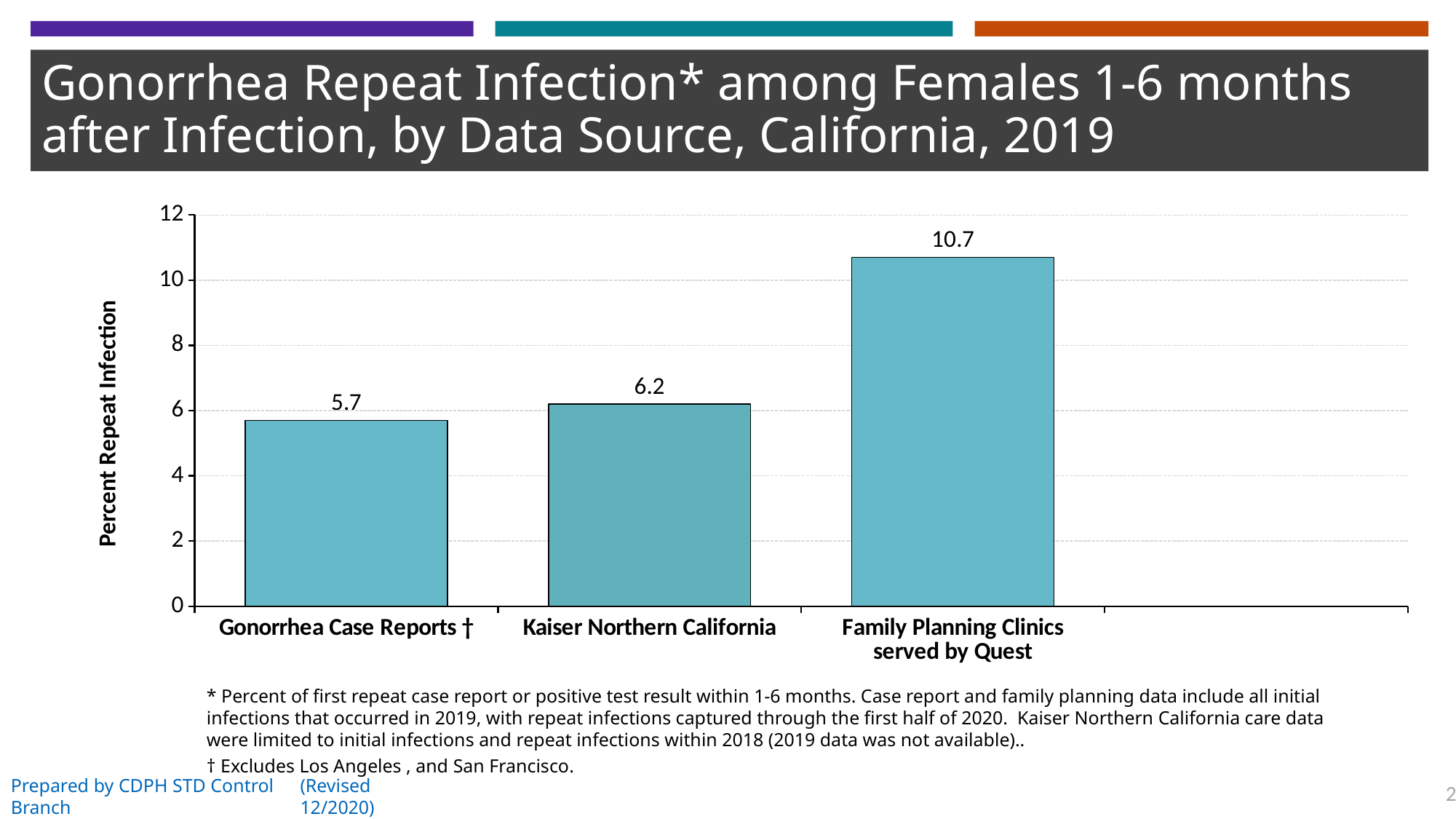
What is the percent repeat infection for Gonorrhea Case Reports? 5.7 What is the percent repeat infection for Family Planning Clinics served by Quest? 10.7 What is the difference in percent repeat infection between Kaiser Northern California and Gonorrhea Case Reports? 0.5 Is the value for Family Planning Clinics served by Quest greater or less than 10? greater Which has a higher percent repeat infection, Kaiser Northern California or Family Planning Clinics served by Quest? Family Planning Clinics served by Quest What is the percent repeat infection for Kaiser Northern California? 6.2 What kind of chart is shown on the slide? Bar chart How many data sources are shown in the chart? 3 Which data source has the lowest percent repeat infection? Gonorrhea Case Reports Which data source has the highest percent repeat infection? Family Planning Clinics served by Quest What is the difference in percent repeat infection between Family Planning Clinics served by Quest and Gonorrhea Case Reports? 5.0 What is the label of the y axis? Percent Repeat Infection